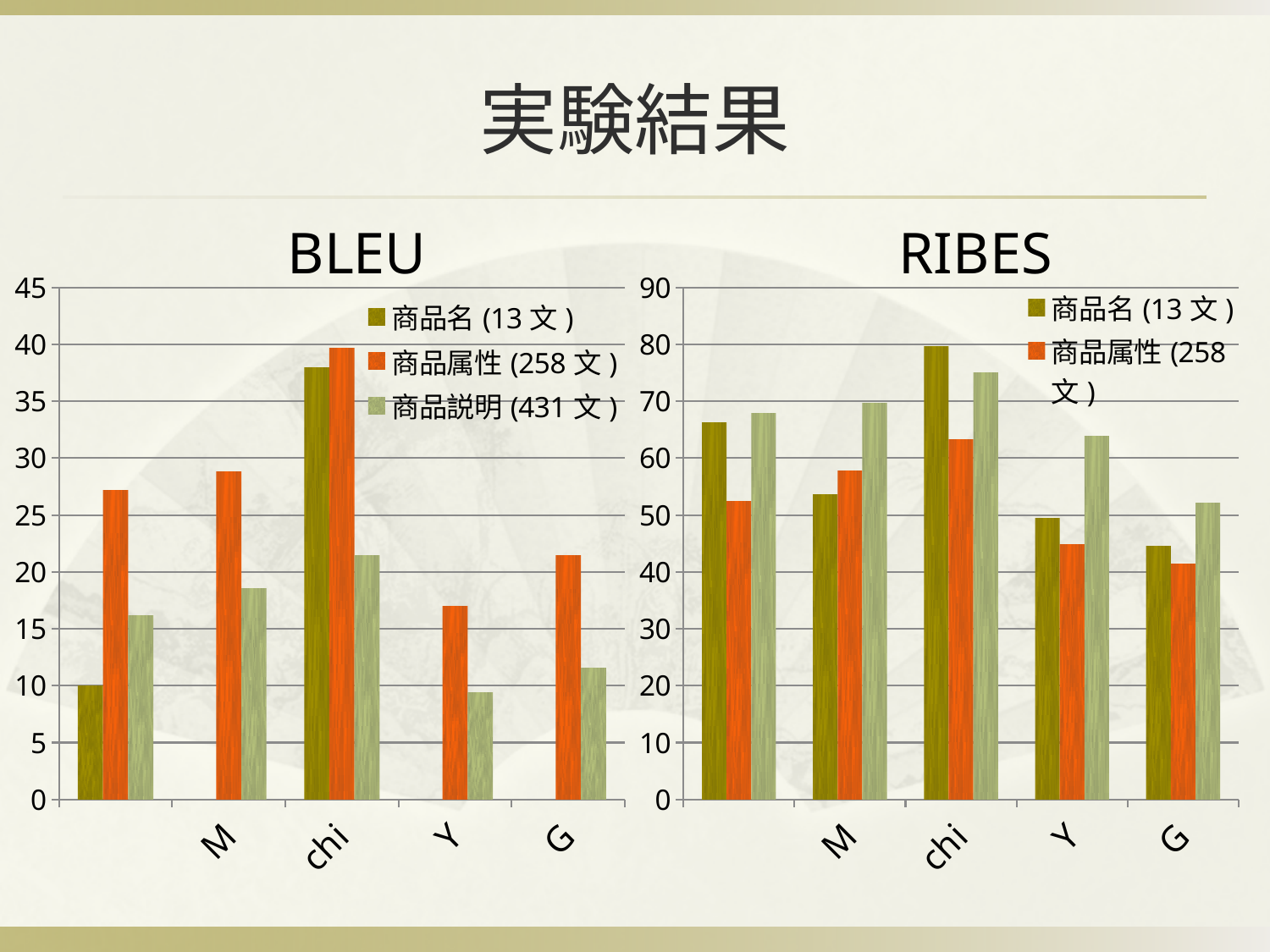
In the RIBES chart, which category has the lowest value for 商品属性 (258 文)? G In the BLEU chart, at chi, which is larger: 商品名 (13 文) or 商品説明 (431 文)? 商品名 (13 文) In the BLEU chart, which category has the highest value for 商品属性 (258 文)? chi How many series does the legend of the BLEU chart list? 3 In the BLEU chart, which category has the lowest value for 商品説明 (431 文)? Y In the RIBES chart, is the value for 商品名 (13 文) at chi greater or less than 70? greater In the RIBES chart, at Y, which is larger: 商品属性 (258 文) or 商品説明 (431 文)? 商品説明 (431 文) What is the title of the chart on the right side of the slide? RIBES In the RIBES chart, which category has the highest value for 商品名 (13 文)? chi What kind of chart is the BLEU chart? bar chart In the BLEU chart, is the value for 商品属性 (258 文) at M greater or less than 25? greater